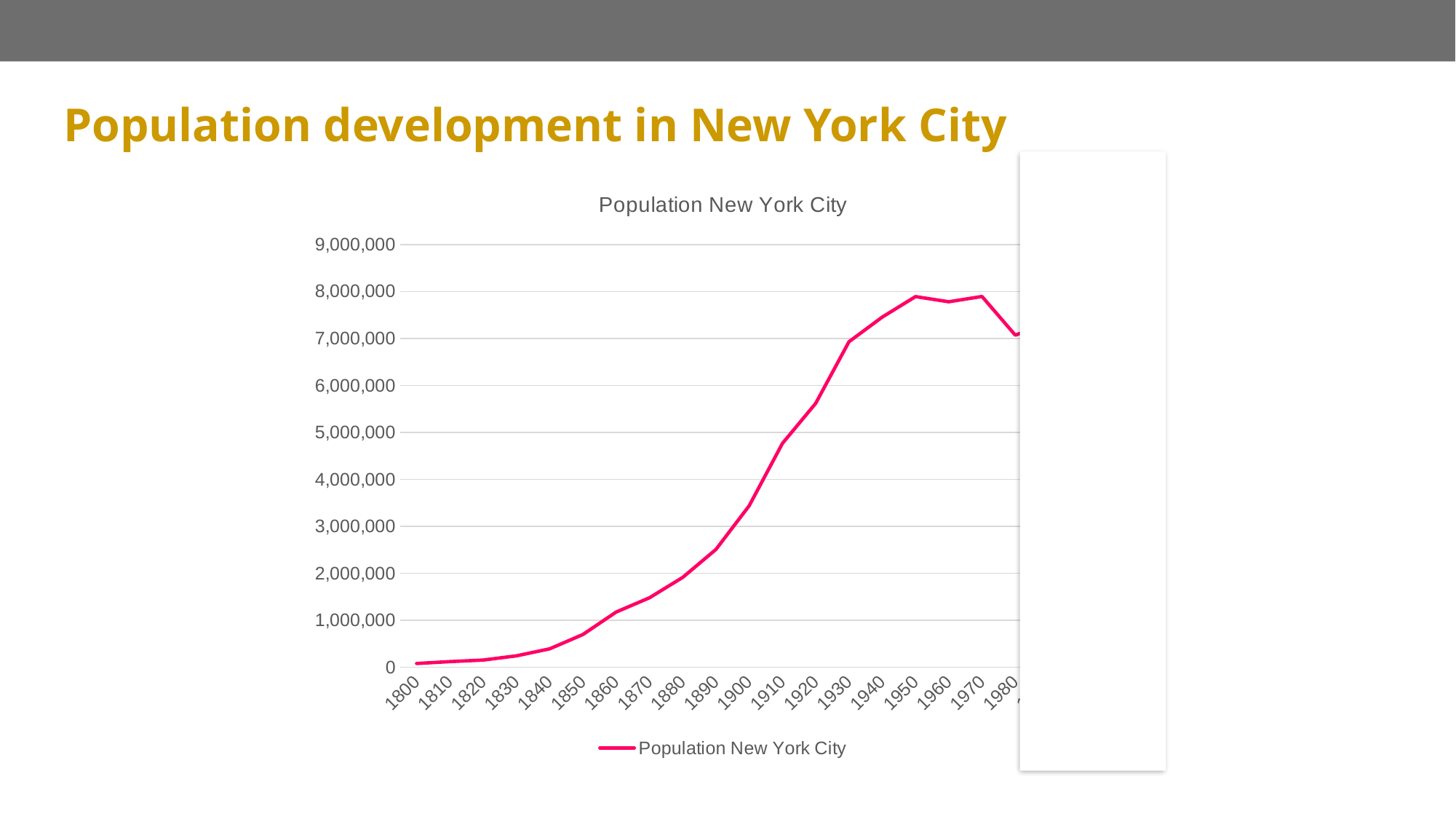
Which year shown has the lowest population? 1800 Is the value for 1900 greater or less than 3,000,000? greater Is the value for 1840 greater or less than 1,000,000? less What is the title of the chart? Population New York City How many series does the legend list? 1 What kind of chart is shown on the slide? line chart Which is larger, the population in 1900 or in 1950? 1950 Does the population rise or fall between 1800 and 1950? rise Is the value for 1920 greater or less than 5,000,000? greater Which is larger, the population in 1860 or in 1880? 1880 What colour is the line in the chart? pink